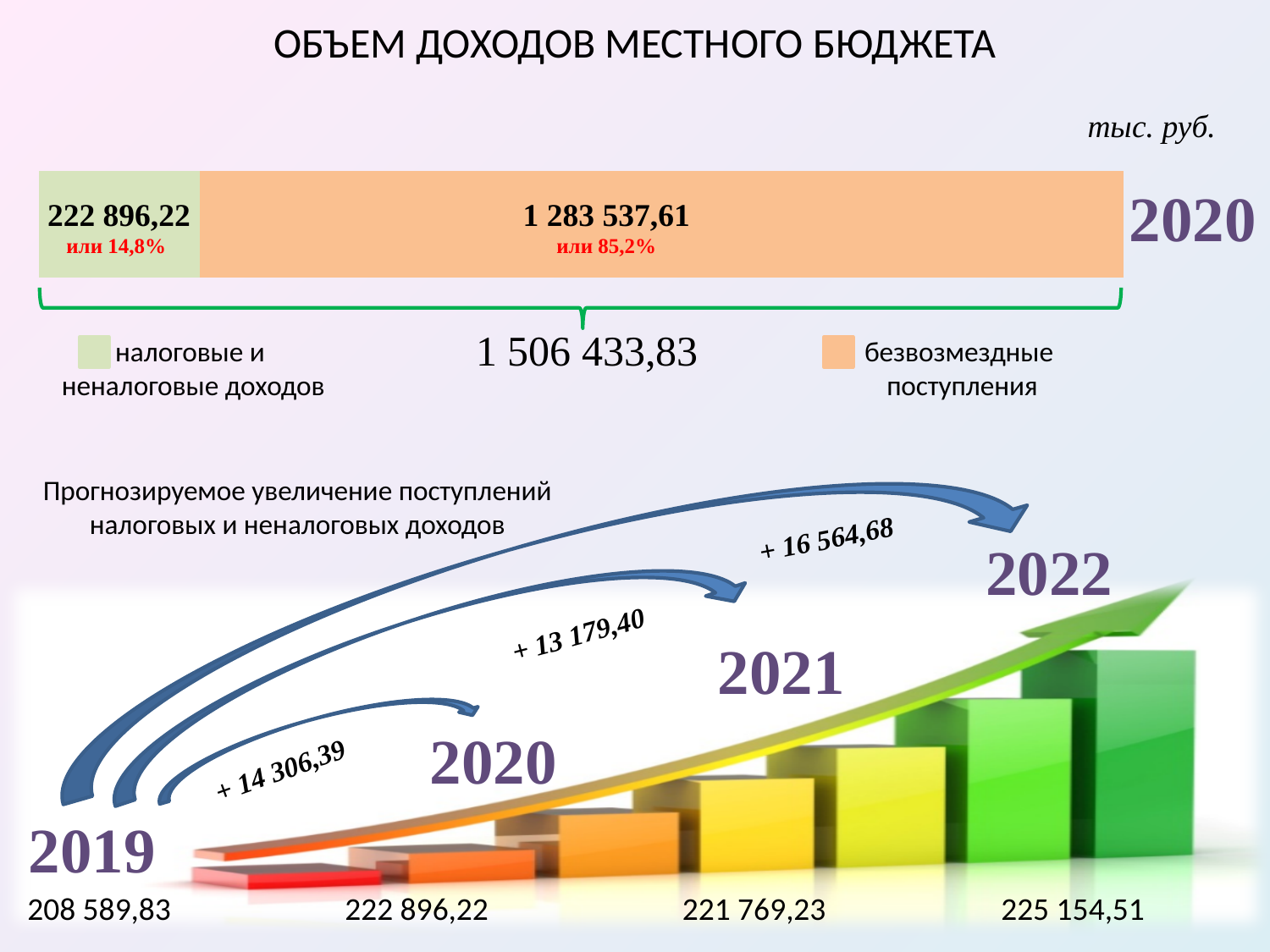
In the bottom bar chart, which year has the highest value? 2022 In the bottom bar chart, which year has the lowest value? 2019 In the bottom bar chart, how many years are shown? 4 In the top stacked bar, what unit of measurement is indicated on the slide? тыс. руб. In the top stacked bar for 2020, what is the total of the two segments? 1 506 433,83 In the bottom bar chart, what is the difference between the values for 2020 and 2019? 14 306,39 In the top stacked bar for 2020, what share of the total do безвозмездные поступления make up? 85,2% In the top stacked bar for 2020, what is the value of безвозмездные поступления? 1 283 537,61 In the bottom bar chart, what is the value for 2022? 225 154,51 In the top stacked bar for 2020, which segment is larger: налоговые и неналоговые доходы or безвозмездные поступления? безвозмездные поступления In the top stacked bar for 2020, what is the value of налоговые и неналоговые доходы? 222 896,22 In the bottom bar chart, what is the value for 2019? 208 589,83